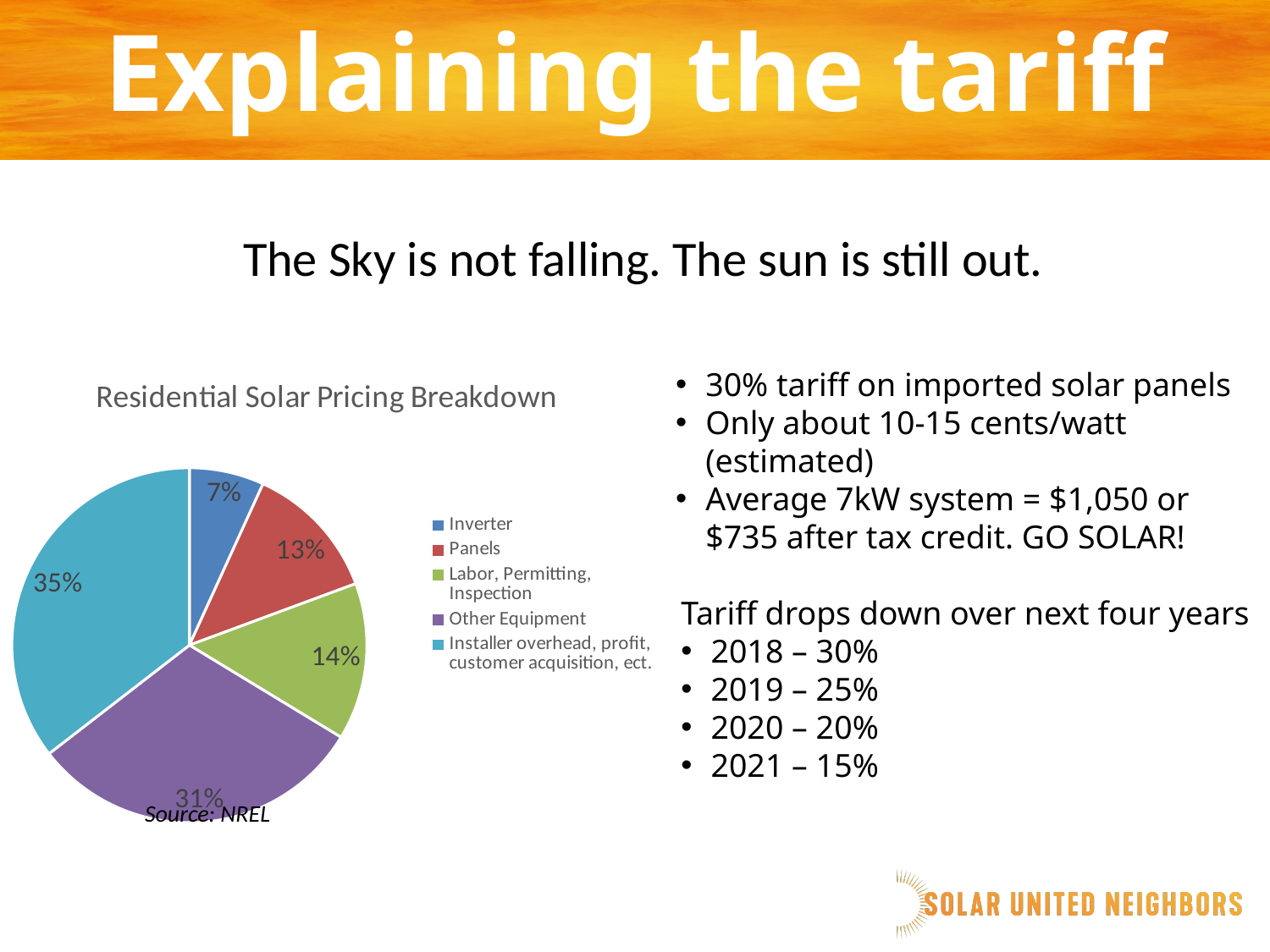
What share of the pie does Inverter represent? 7% How many categories does the legend list? 5 What share of the pie does Other Equipment represent? 31% What share of the pie does Installer overhead, profit, customer acquisition, ect. represent? 35% Which category has the largest share of the pie? Installer overhead, profit, customer acquisition, ect. What is the title of the chart? Residential Solar Pricing Breakdown What share of the pie does Panels represent? 13% Which category has the smallest share of the pie? Inverter Which is larger, the share for Panels or the share for Labor, Permitting, Inspection? Labor, Permitting, Inspection What share of the pie does Labor, Permitting, Inspection represent? 14% What is the difference in percentage points between Other Equipment and Panels? 18 What type of chart is shown on the slide? pie chart